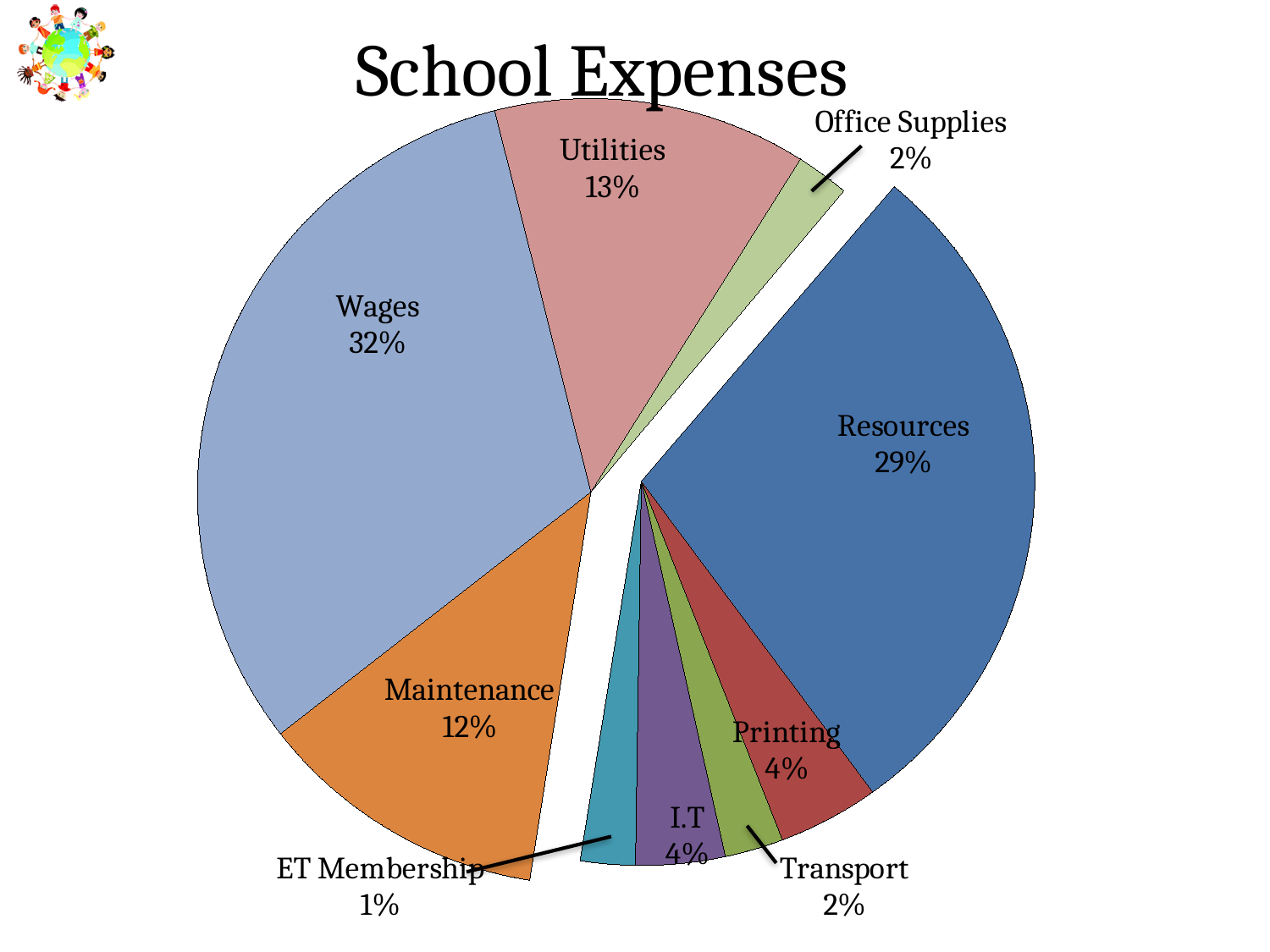
What is the difference in percentage points between Utilities and Printing? 9 What type of chart is shown on the slide? pie chart What is the difference in percentage points between Wages and Resources? 3 What percentage of school expenses is Resources? 29% What is the title of the chart? School Expenses What percentage of school expenses is ET Membership? 1% How many categories are shown in the pie chart? 9 What percentage of school expenses is Wages? 32% Which category has the largest share of school expenses? Wages Which category has the smallest share of school expenses? ET Membership What percentage of school expenses is Maintenance? 12% Which is larger, Utilities or Maintenance? Utilities